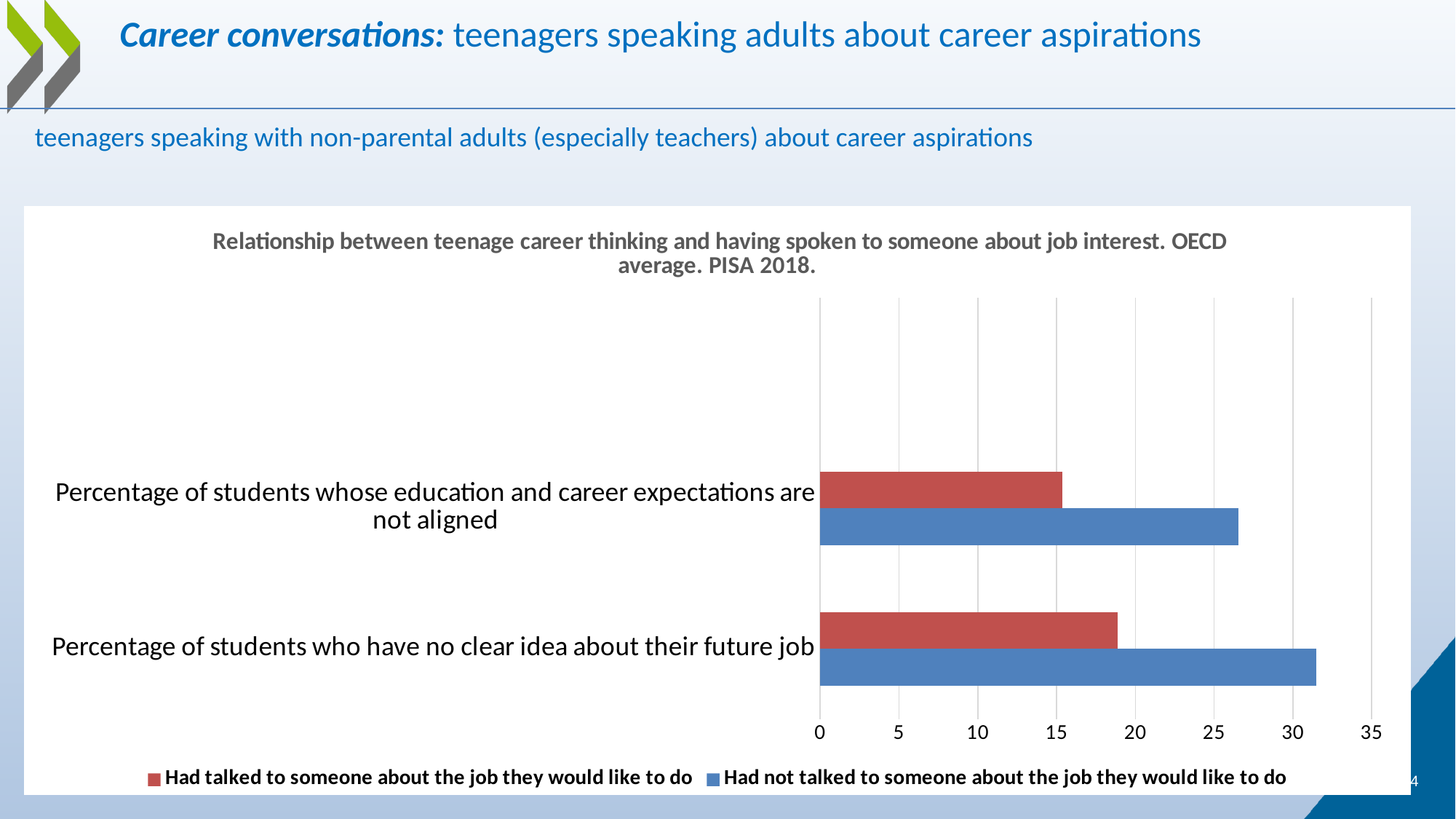
Is the value for 'Had talked to someone about the job they would like to do' in 'Percentage of students who have no clear idea about their future job' greater or less than 20? less Which category has the lowest value for 'Had talked to someone about the job they would like to do'? Percentage of students whose education and career expectations are not aligned Is the value for 'Had not talked to someone about the job they would like to do' in 'Percentage of students who have no clear idea about their future job' greater or less than 30? greater What kind of chart is shown on the slide? bar chart For 'Percentage of students who have no clear idea about their future job', which series has the larger value: 'Had talked to someone about the job they would like to do' or 'Had not talked to someone about the job they would like to do'? Had not talked to someone about the job they would like to do For 'Percentage of students whose education and career expectations are not aligned', which series has the larger value: 'Had talked to someone about the job they would like to do' or 'Had not talked to someone about the job they would like to do'? Had not talked to someone about the job they would like to do How many series does the legend list? 2 How many categories are shown on the chart? 2 Which category has the highest value for 'Had not talked to someone about the job they would like to do'? Percentage of students who have no clear idea about their future job Is the value for 'Had not talked to someone about the job they would like to do' in 'Percentage of students whose education and career expectations are not aligned' greater or less than 25? greater What is the title of the chart? Relationship between teenage career thinking and having spoken to someone about job interest. OECD average. PISA 2018. Which series is shown in blue in the legend? Had not talked to someone about the job they would like to do